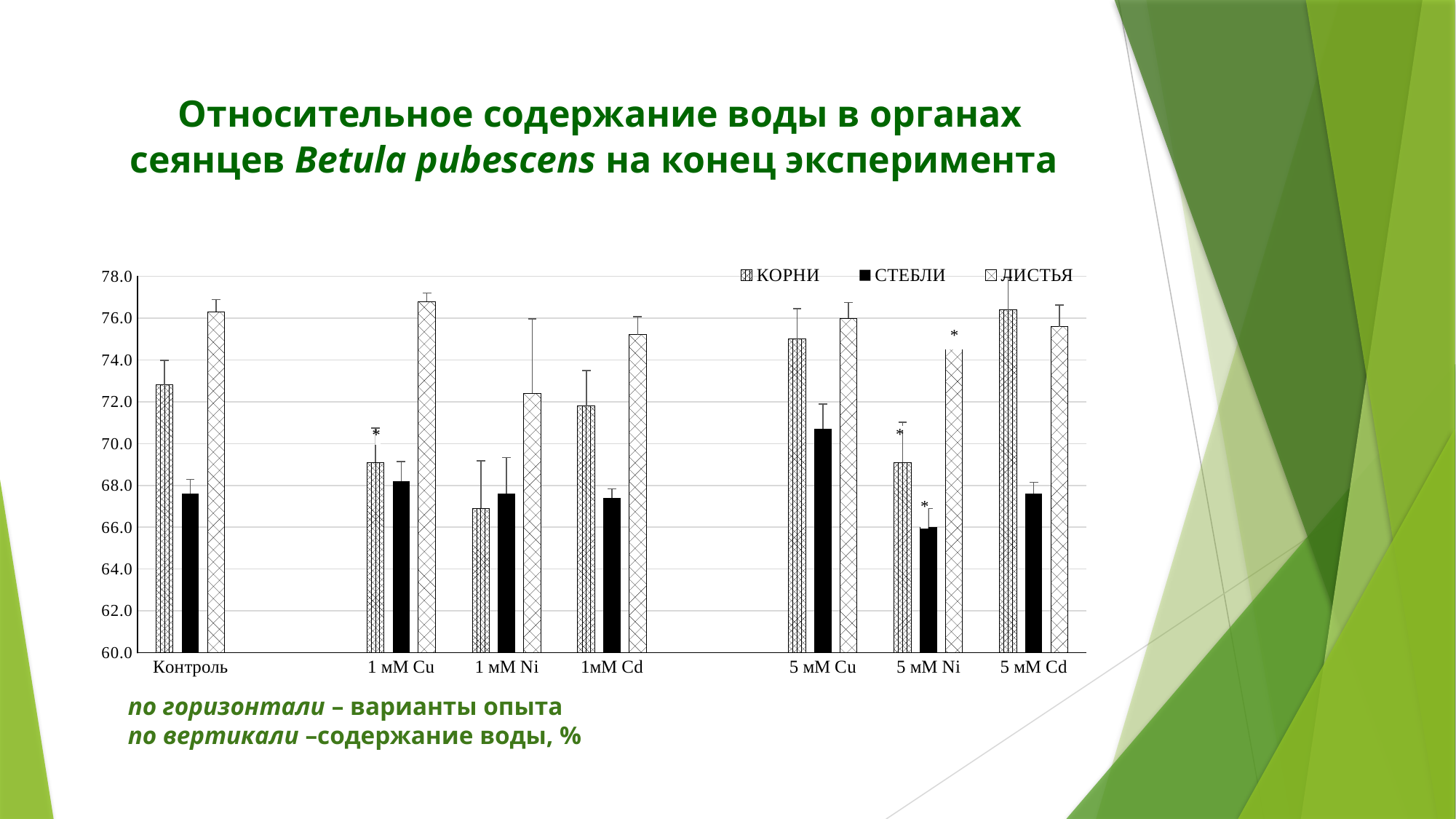
Which series is drawn with solid black bars? СТЕБЛИ Is the ЛИСТЬЯ value for 1 мМ Cu greater or less than 76.0? greater Which category has the lowest value for СТЕБЛИ? 5 мМ Ni How many series does the legend list? 3 Which category has the lowest value for КОРНИ? 1 мМ Ni How many experimental variants (categories) are shown on the x axis? 7 Which is larger: the КОРНИ value for Контроль or the КОРНИ value for 1 мМ Cu? Контроль Is the СТЕБЛИ value for 5 мМ Ni greater or less than 68.0? less Is the КОРНИ value for Контроль greater or less than 72.0? greater Which category has the highest value for СТЕБЛИ? 5 мМ Cu Which category has the lowest value for ЛИСТЬЯ? 1 мМ Ni What kind of chart is shown on the slide? bar chart